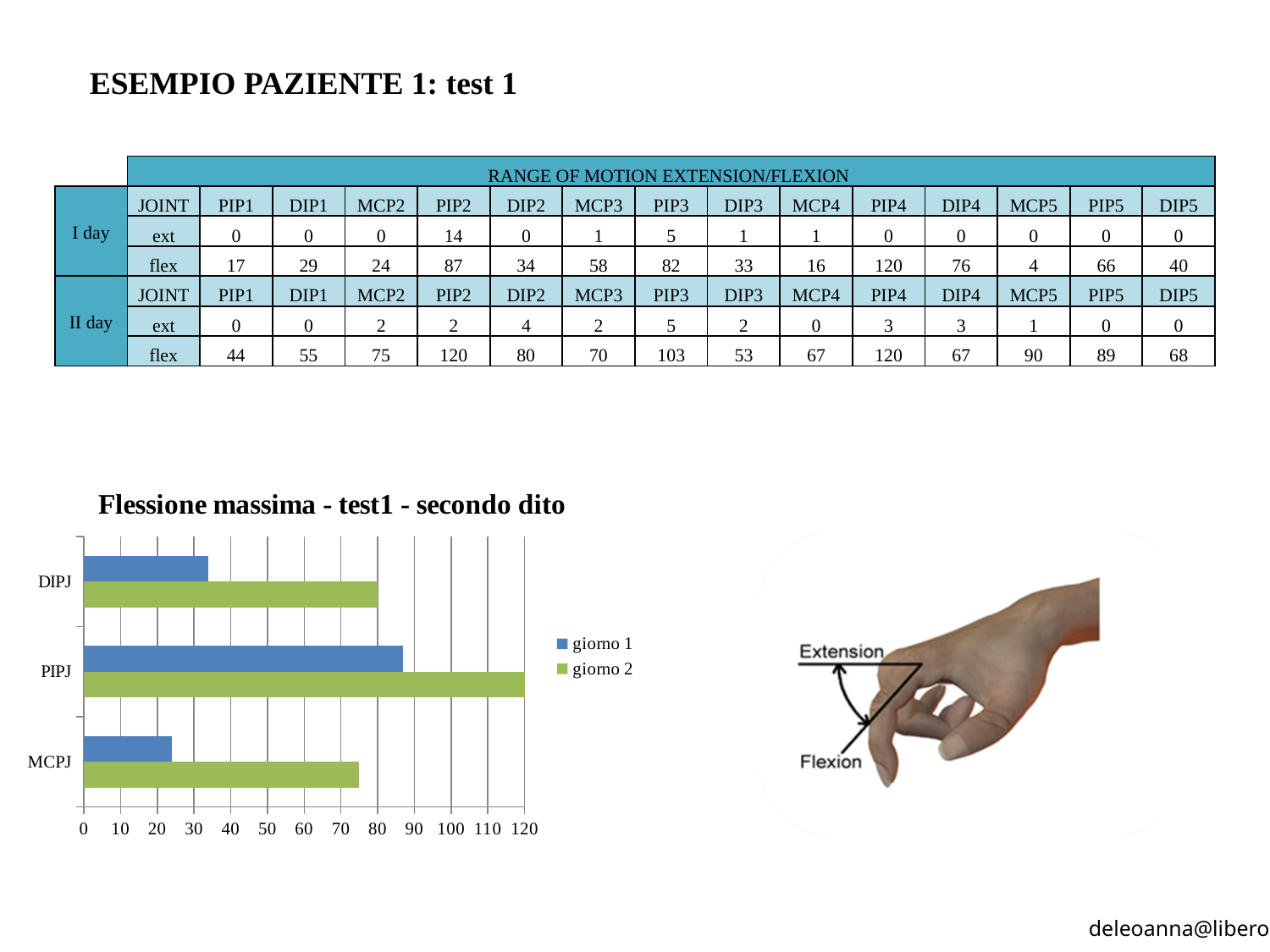
How many joint categories are plotted in the chart? 3 What is the value for PIPJ in the giorno 2 series? 120 How many series does the legend of the chart list? 2 Which joint has the lowest giorno 1 value? MCPJ Is the giorno 1 value for MCPJ greater or less than 30? less For DIPJ, which series has the larger value, giorno 1 or giorno 2? giorno 2 What is the title of the chart? Flessione massima - test1 - secondo dito What kind of chart is shown on the slide? bar chart What are the two entries in the chart's legend? giorno 1, giorno 2 Is the giorno 1 value for PIPJ greater or less than 80? greater What is the value for DIPJ in the giorno 2 series? 80 Which joint has the highest giorno 2 value? PIPJ